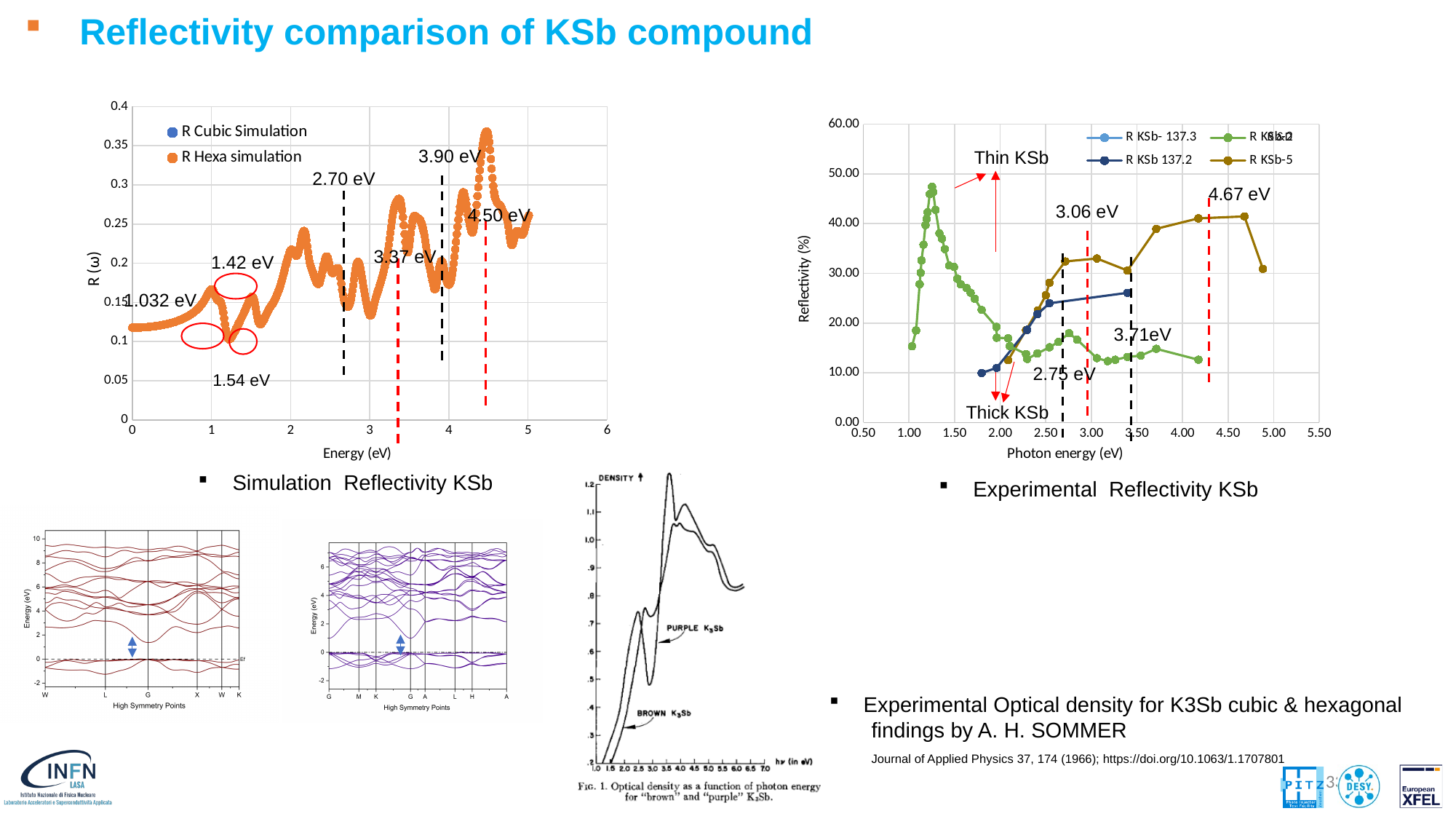
What kind of chart is the Experimental Reflectivity KSb chart? line chart On the Simulation Reflectivity KSb chart, how many series does the legend list? 2 On the Simulation Reflectivity KSb chart, is the peak value near 4.50 eV greater or less than 0.35? greater On the Simulation Reflectivity KSb chart, what is the label of the y axis? R (ω) On the Simulation Reflectivity KSb chart, is the value at 3.90 eV greater or less than 0.2? less On the Simulation Reflectivity KSb chart, is the value at 3.37 eV greater or less than 0.25? greater On the Experimental Reflectivity KSb chart, how many series does the legend list? 4 On the Experimental Reflectivity KSb chart, what is the label of the x axis? Photon energy (eV) On the Experimental Reflectivity KSb chart, does the R KSb-5 series rise or fall between 2.00 eV and 4.67 eV? rise On the Simulation Reflectivity KSb chart, what is the maximum value shown on the y axis? 0.4